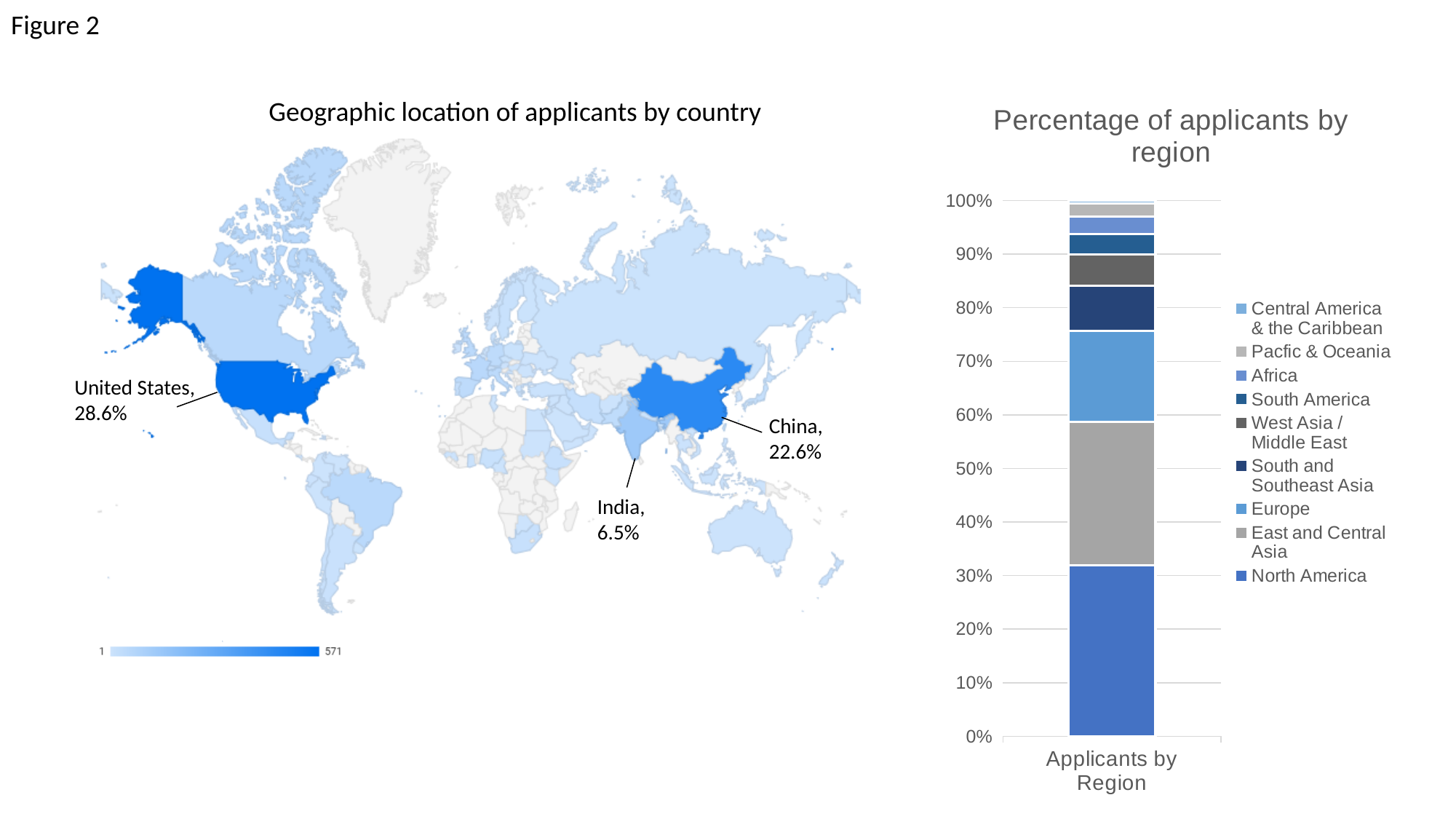
On the map chart 'Geographic location of applicants by country', which has a larger labelled percentage, China or India? China What kind of chart is 'Percentage of applicants by region'? Stacked bar chart On the map chart 'Geographic location of applicants by country', what are the minimum and maximum values shown on the colour scale? 1 and 571 In the 'Percentage of applicants by region' chart, which region has the largest segment? North America In the 'Percentage of applicants by region' chart, which segment is larger, Europe or Africa? Europe How many series does the legend of the 'Percentage of applicants by region' chart list? 9 On the map chart 'Geographic location of applicants by country', which of the labelled countries has the highest percentage of applicants? United States On the map chart 'Geographic location of applicants by country', what is the difference between the percentages labelled for the United States and China? 6.0% On the map chart 'Geographic location of applicants by country', what percentage of applicants is labelled for the United States? 28.6% In the 'Percentage of applicants by region' chart, is the value for North America greater or less than 30%? greater On the map chart 'Geographic location of applicants by country', what percentage of applicants is labelled for China? 22.6% On the map chart 'Geographic location of applicants by country', what percentage of applicants is labelled for India? 6.5%